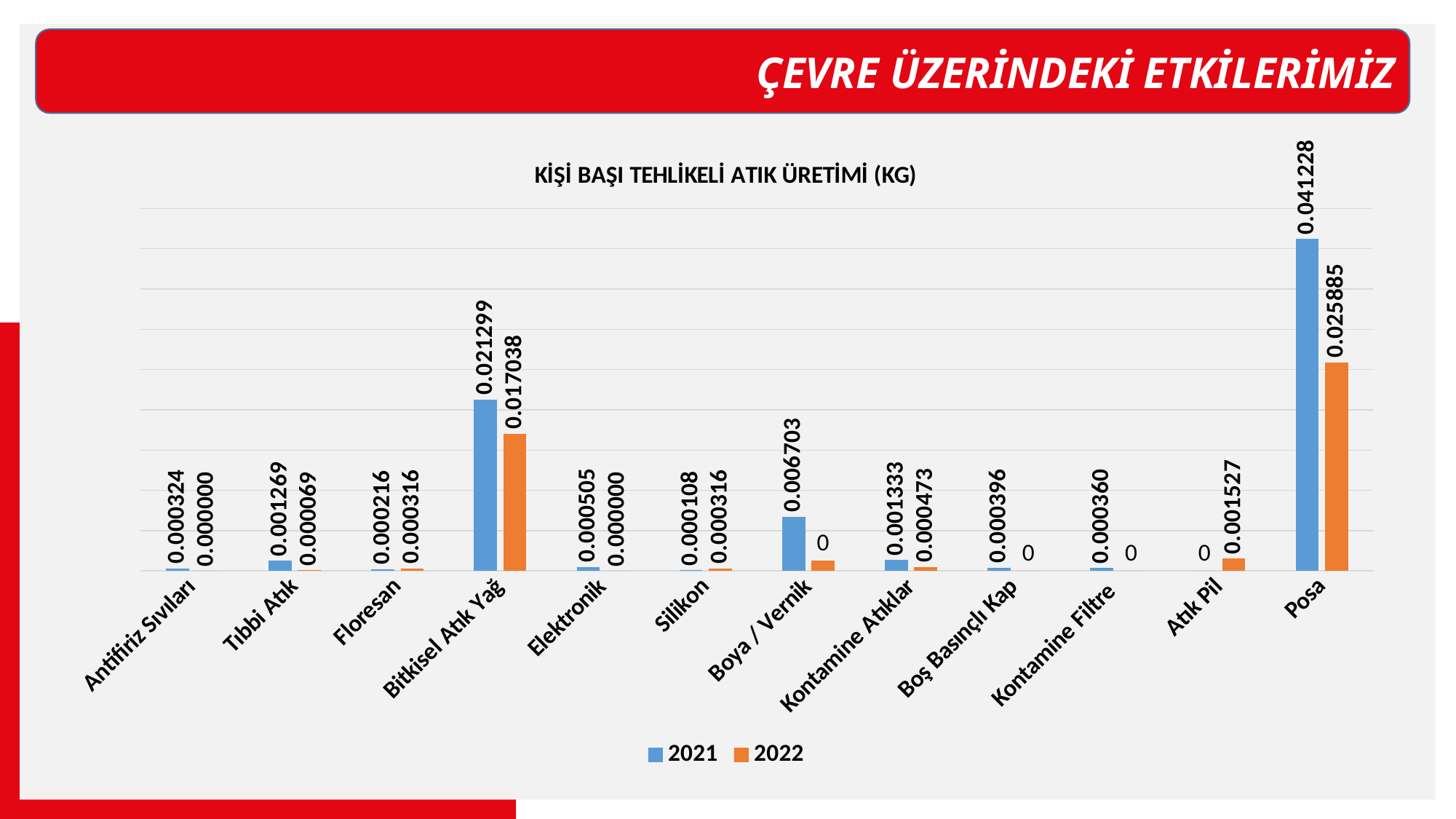
What is the 2021 value for Kontamine Atıklar? 0.001333 What type of chart is shown on the slide? bar chart What is the 2021 value for Posa? 0.041228 What is the 2022 value for Bitkisel Atık Yağ? 0.017038 How many categories are shown on the x axis? 12 What is the difference between the 2021 and 2022 values for Posa? 0.015343 How many series does the legend list? 2 Which category has the highest 2022 value? Posa What is the title of the chart? KİŞİ BAŞI TEHLİKELİ ATIK ÜRETİMİ (KG) Which is larger for Bitkisel Atık Yağ, the 2021 value or the 2022 value? 2021 Which category has the highest 2021 value? Posa What is the 2022 value for Atık Pil? 0.001527